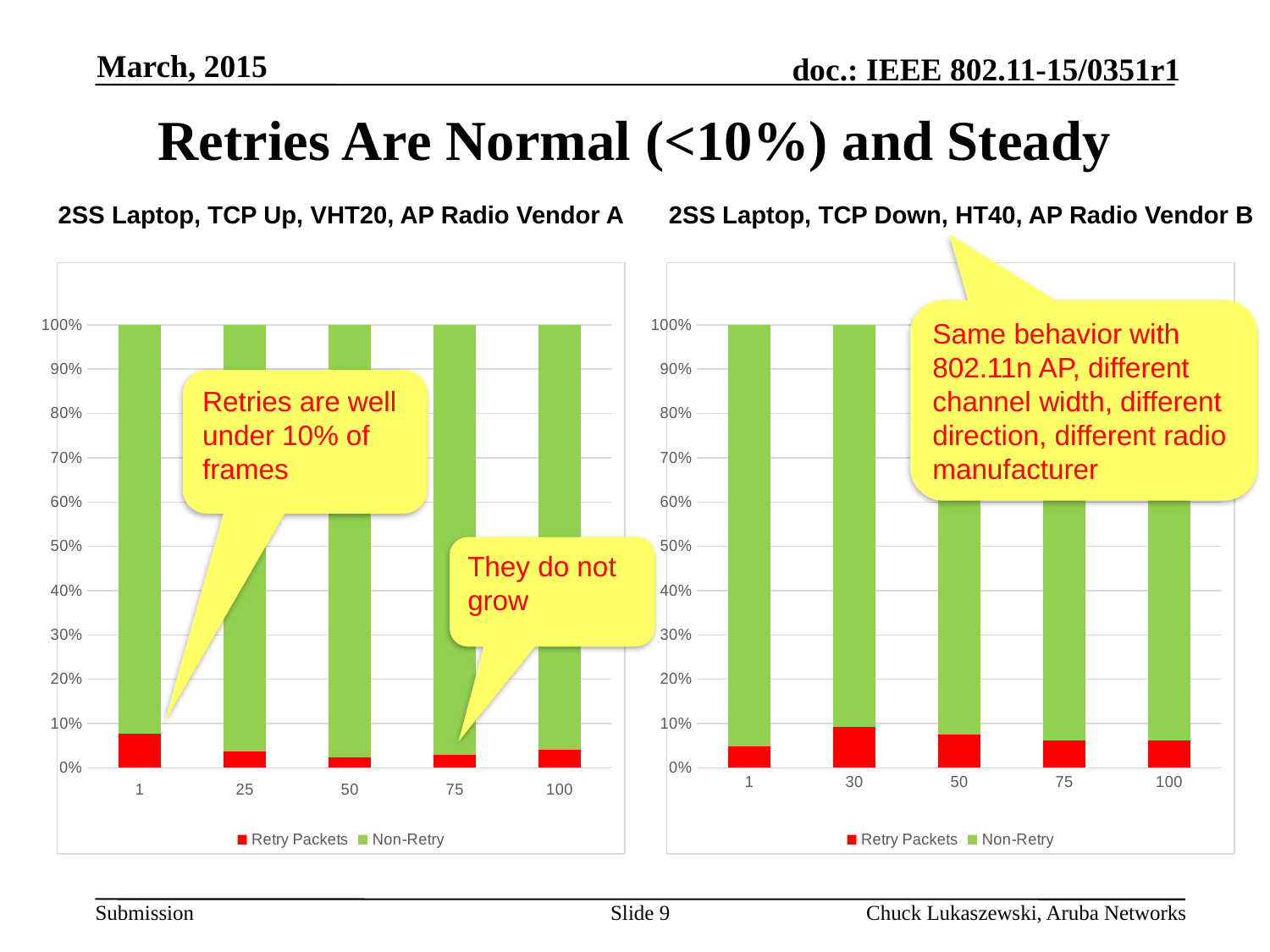
What kind of chart is the left chart titled '2SS Laptop, TCP Up, VHT20, AP Radio Vendor A'? Stacked bar chart What colour represents the Retry Packets series in both charts? Red In the left chart ('2SS Laptop, TCP Up, VHT20, AP Radio Vendor A'), what is the total height of the stacked bar for category 25? 100% In the left chart ('2SS Laptop, TCP Up, VHT20, AP Radio Vendor A'), which is larger, the Retry Packets share for category 1 or for category 50? 1 In the right chart ('2SS Laptop, TCP Down, HT40, AP Radio Vendor B'), which is larger, the Retry Packets share for category 30 or for category 1? 30 How many series does the legend of the right chart ('2SS Laptop, TCP Down, HT40, AP Radio Vendor B') list? 2 How many categories are shown on the x axis of the left chart ('2SS Laptop, TCP Up, VHT20, AP Radio Vendor A')? 5 In the left chart ('2SS Laptop, TCP Up, VHT20, AP Radio Vendor A'), is the Retry Packets value for category 1 greater or less than 10%? less In the left chart ('2SS Laptop, TCP Up, VHT20, AP Radio Vendor A'), which category has the highest Retry Packets share? 1 In the right chart ('2SS Laptop, TCP Down, HT40, AP Radio Vendor B'), which category has the highest Retry Packets share? 30 In the right chart ('2SS Laptop, TCP Down, HT40, AP Radio Vendor B'), is the Non-Retry value for category 1 greater or less than 90%? greater